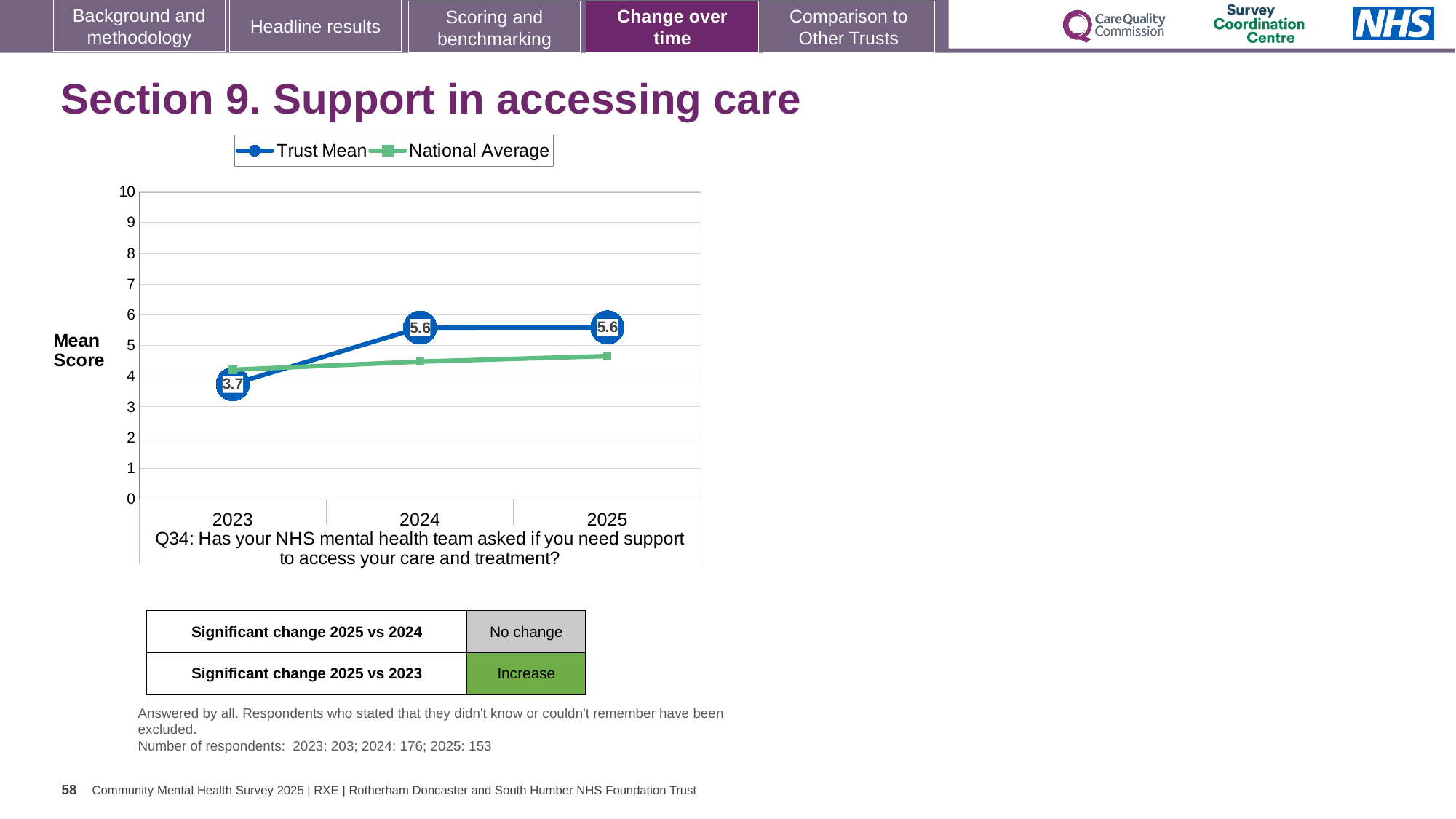
Is the National Average value for 2023 greater or less than 5? less How many years are shown on the x axis of the chart? 3 In 2025, which is higher: the Trust Mean or the National Average? Trust Mean In which year was the Trust Mean score lowest? 2023 How many series does the chart legend list? 2 What is the Trust Mean score for 2025? 5.6 By how much did the Trust Mean score increase from 2023 to 2024? 1.9 In 2023, which is higher: the Trust Mean or the National Average? National Average What type of chart is shown on the slide? Line chart What is the Trust Mean score for 2023? 3.7 Is the National Average value for 2025 greater or less than 4? greater What is the Trust Mean score for 2024? 5.6